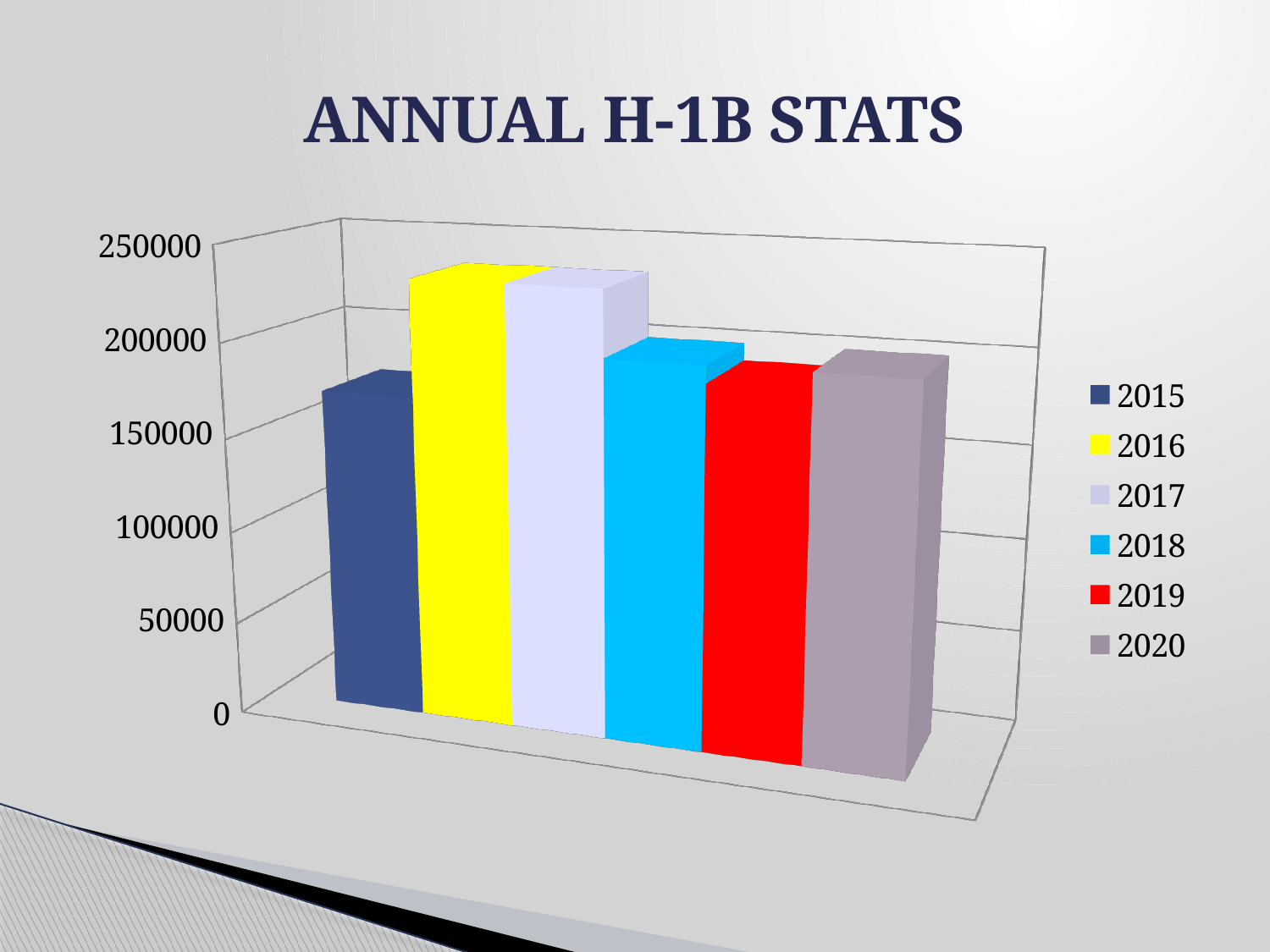
Which is larger, the value for 2015 or the value for 2016? 2016 Is the value for 2019 greater or less than 150000? greater What colour is the bar for 2016? yellow What is the title of the chart? ANNUAL H-1B STATS How many entries does the legend list? 6 What kind of chart is shown on the slide? bar chart Is the value for 2015 greater or less than 200000? less How many bars are plotted in the chart? 6 Which year has the lowest value in the chart? 2015 Which is larger, the value for 2017 or the value for 2018? 2017 Is the value for 2016 greater or less than 200000? greater